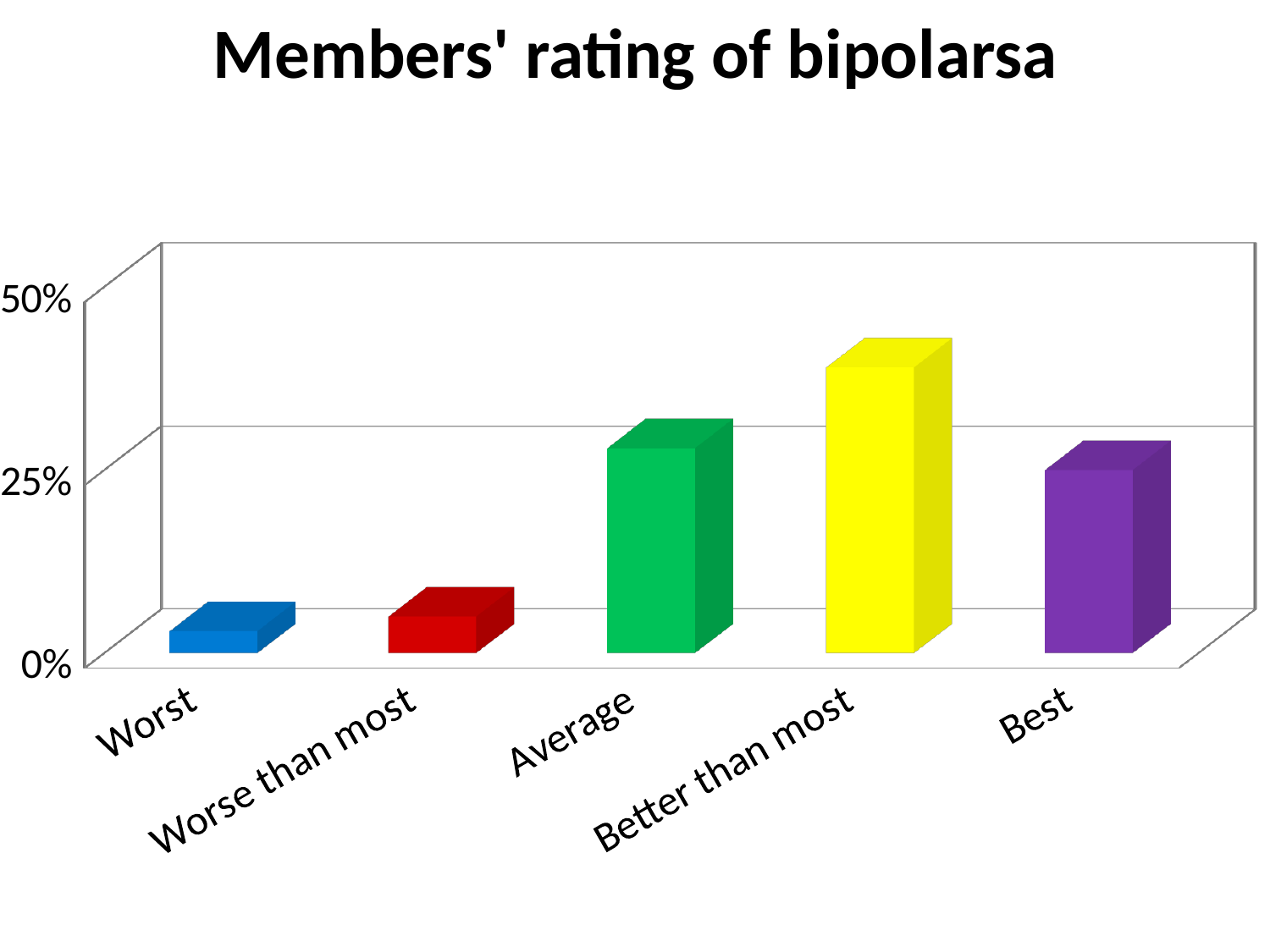
Is the value for Worse than most greater or less than 25%? less Is the value for Better than most greater or less than 25%? greater Do the values rise or fall from Worst to Better than most along the x axis? rise What kind of chart is shown on the slide? bar chart Which is larger, the value for Better than most or the value for Average? Better than most Is the value for Worst greater or less than 25%? less Which is larger, the value for Worse than most or the value for Worst? Worse than most What is the title of the chart? Members' rating of bipolarsa Which rating category has the highest value? Better than most Which rating category has the lowest value? Worst How many rating categories are shown on the x axis? 5